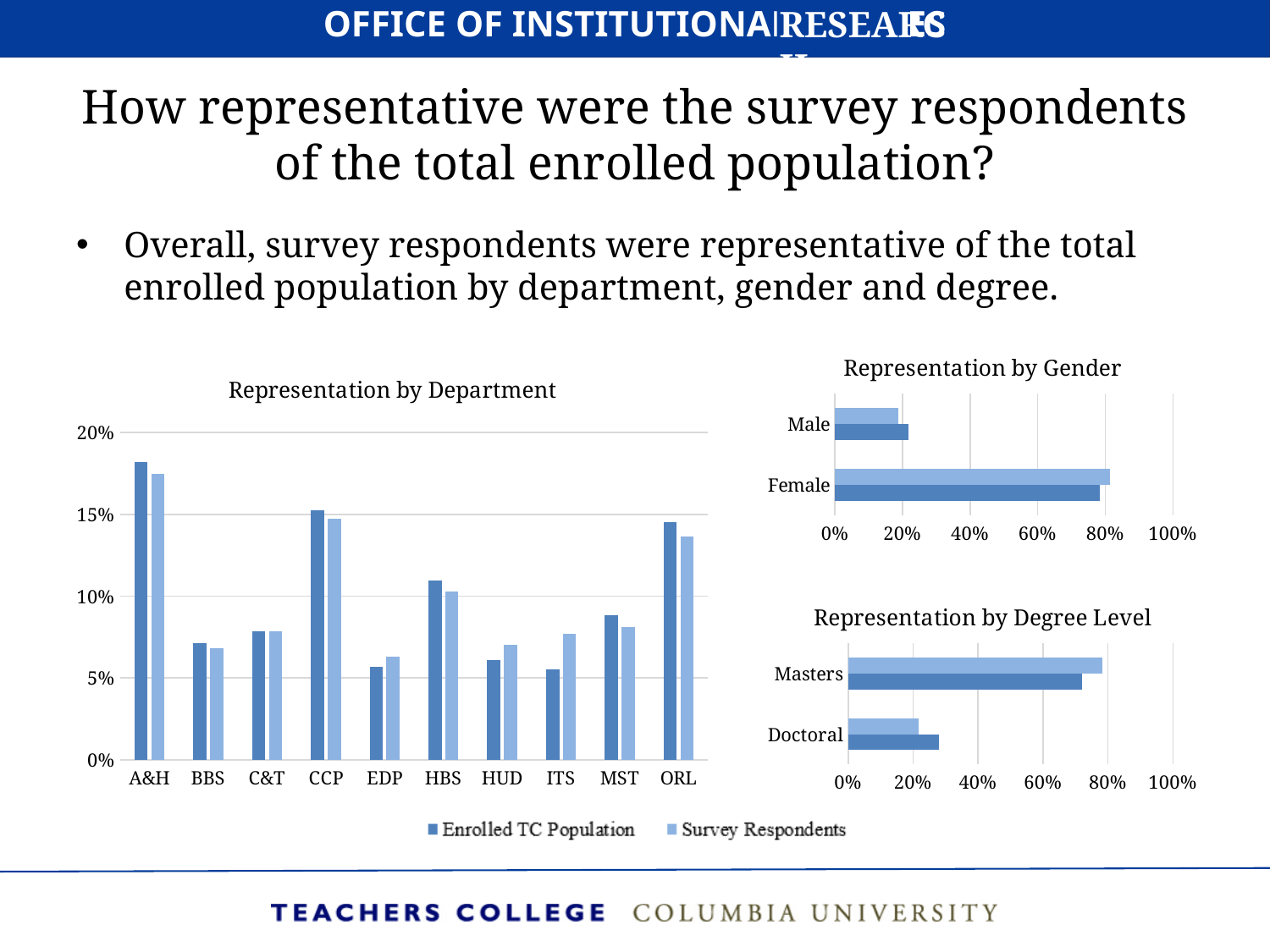
In the "Representation by Department" chart, which has the larger Enrolled TC Population value, ORL or HBS? ORL In the "Representation by Department" chart, how many departments are shown on the x axis? 10 How many series does the legend of the "Representation by Department" chart list? 2 In the "Representation by Gender" chart, is the Survey Respondents value for Female greater or less than 60%? greater In the "Representation by Gender" chart, is the Enrolled TC Population value for Male greater or less than 40%? less In the "Representation by Department" chart, which department has the highest Enrolled TC Population value? A&H In the "Representation by Degree Level" chart, which degree level has the higher Enrolled TC Population value? Masters In the "Representation by Department" chart, is the Survey Respondents value for EDP greater or less than 10%? less In the "Representation by Department" chart, for ITS, which is larger: Enrolled TC Population or Survey Respondents? Survey Respondents What kind of chart is the "Representation by Department" chart? bar chart